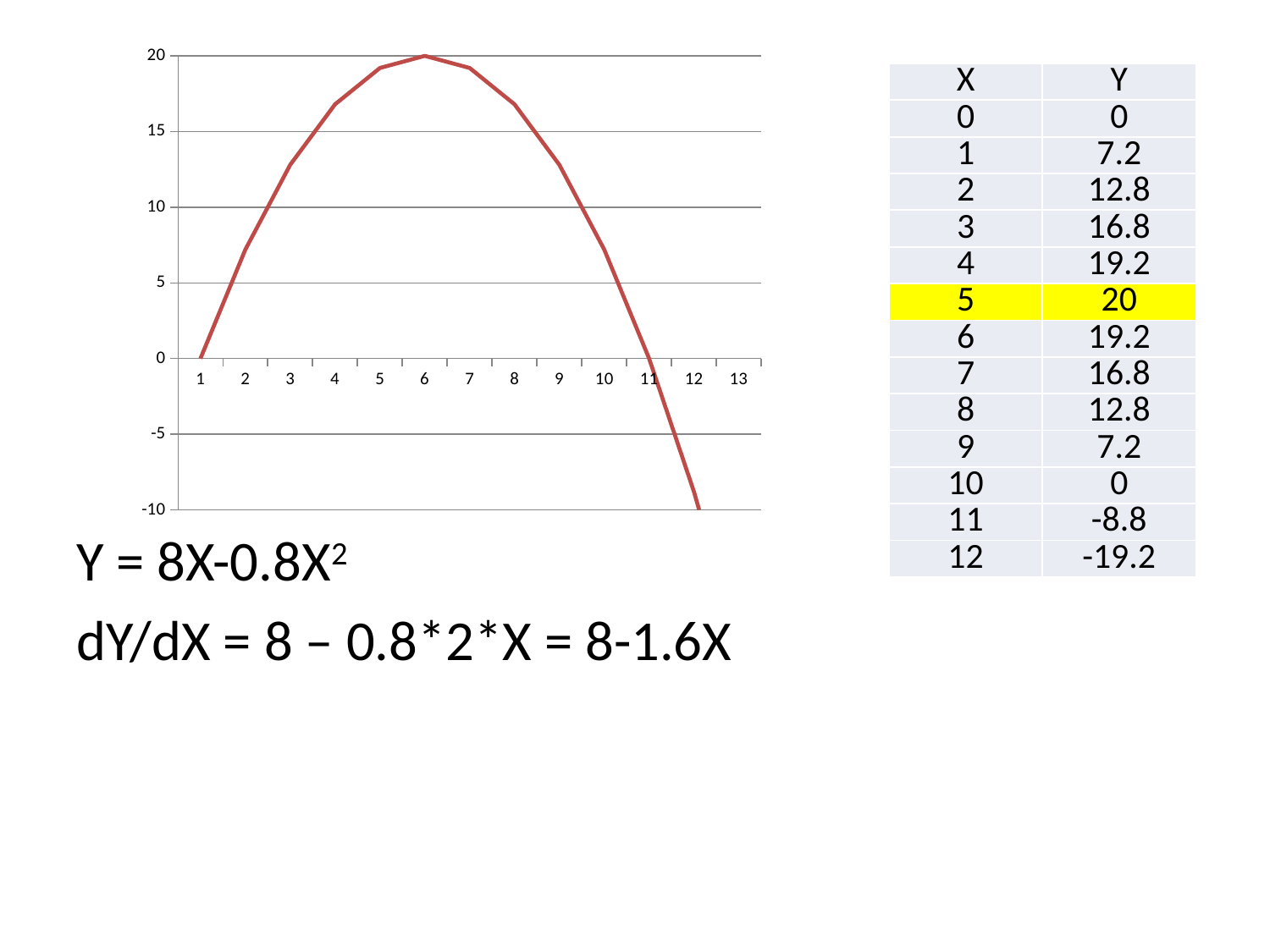
What is the highest value the line reaches on the chart? 20 Which is larger, the value of the line at x-axis label 2 or at x-axis label 11? x-axis label 2 Does the line rise or fall between x-axis labels 6 and 13? falls Is the value of the line at x-axis label 12 greater or less than -5? less What kind of chart is shown on the slide? line chart What is the value of the line at x-axis label 1? 0 Does the line rise or fall between x-axis labels 1 and 6? rises What colour is the line plotted on the chart? red Is the value of the line at x-axis label 3 greater or less than 10? greater At which x-axis label does the line reach its peak? 6 How many labels are shown on the x axis of the chart? 13 At which x-axis label does the line come back down to 0? 11